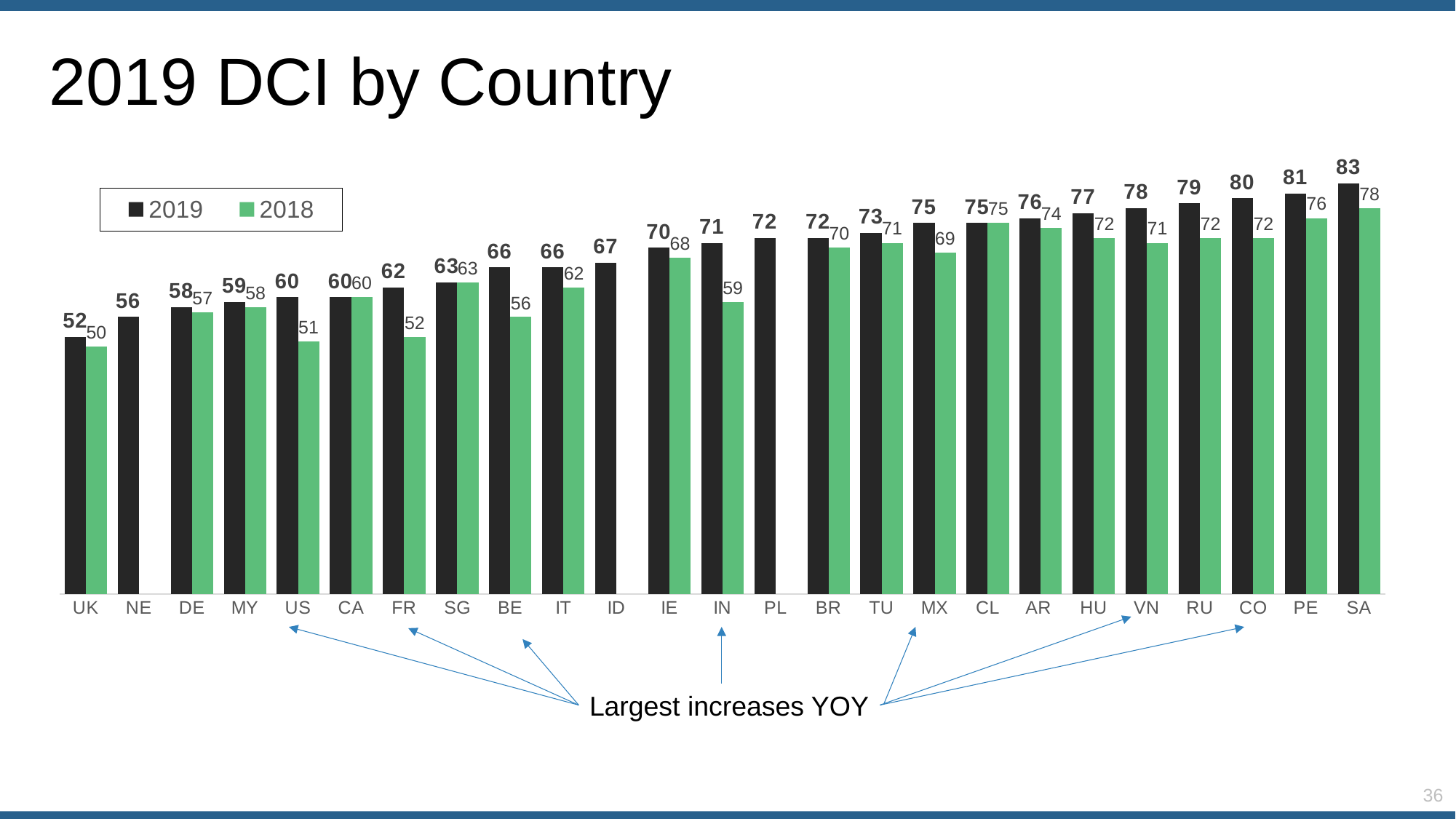
Do the 2019 values rise or fall from UK to SA along the x axis? Rise How many countries are shown on the x axis? 25 What is the difference between the 2019 and 2018 values for BE? 10 How many series does the legend list? 2 What kind of chart is shown on the slide? Bar chart What is the 2019 value for IN? 71 What is the 2019 value for SA? 83 Which country has the highest 2019 value? SA Which country has the lowest 2019 value? UK Which is larger, the 2019 value for FR or the 2019 value for SG? SG What is the difference between the 2019 and 2018 values for IN? 12 What is the 2018 value for US? 51